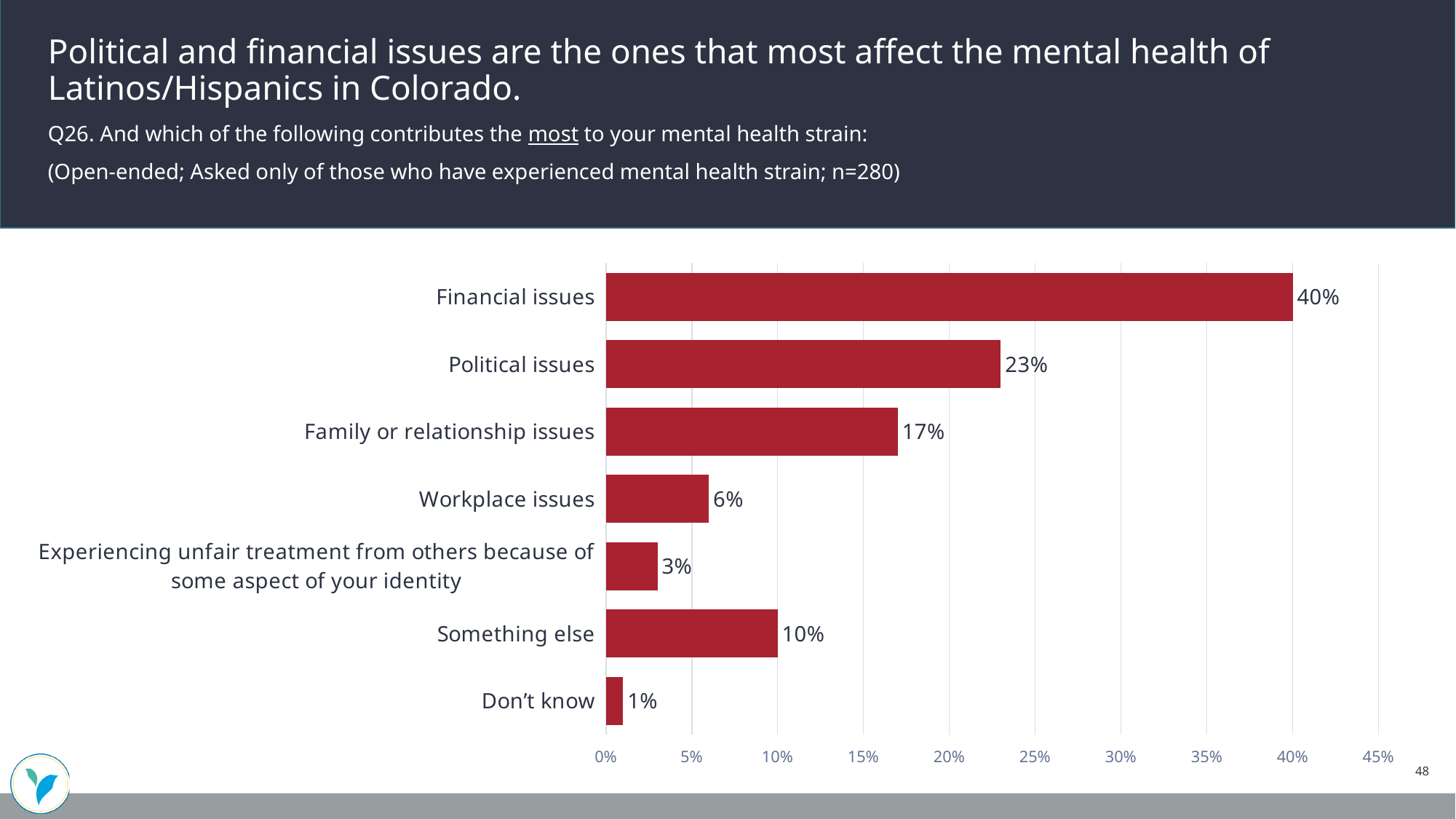
Which is larger: the value for Something else or the value for Workplace issues? Something else Which category has the lowest value in the chart? Don't know What is the value for Workplace issues? 6% What is the difference between the values for Financial issues and Political issues? 17% What percentage of respondents said financial issues contribute the most to their mental health strain? 40% What is the value shown for Political issues? 23% What kind of chart is shown on the slide? Bar chart What is the highest value shown on the x axis of the chart? 45% Which category has the highest value in the chart? Financial issues What percentage is shown for Family or relationship issues? 17% Is the value for Political issues greater or less than 20%? greater How many categories are shown in the chart? 7